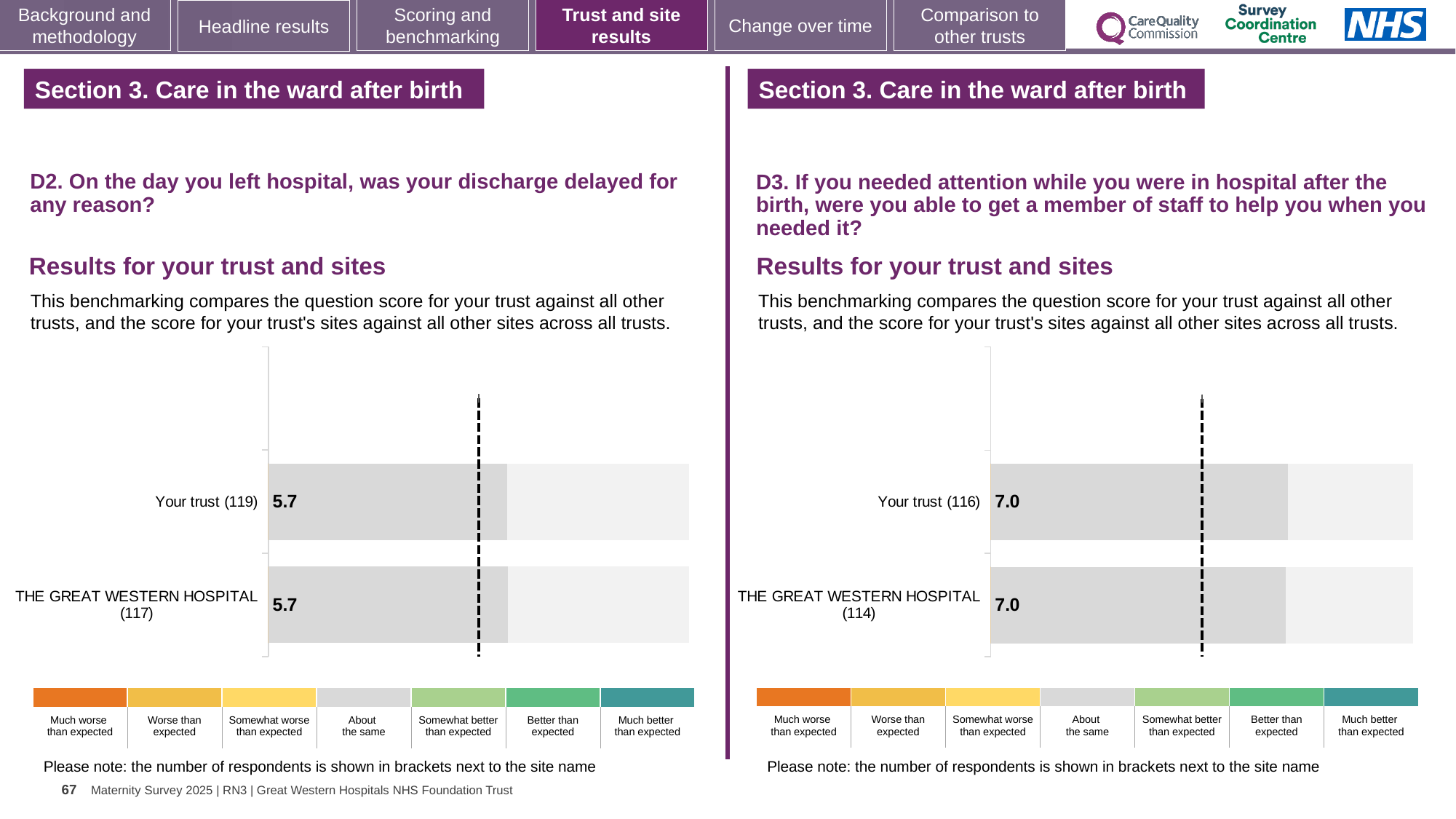
In the D2 chart on the left, what is the difference between the score for Your trust and the score for THE GREAT WESTERN HOSPITAL? 0.0 What kind of chart is the D2 chart on the left? Bar chart In the D2 chart on the left, what is the score for THE GREAT WESTERN HOSPITAL? 5.7 In the D3 chart on the right, what is the score for Your trust? 7.0 In the D2 chart on the left, how many respondents are shown in brackets for Your trust? 119 In the D3 chart on the right, what is the score for THE GREAT WESTERN HOSPITAL? 7.0 In the D3 chart on the right, how many respondents are shown in brackets for Your trust? 116 In the D2 chart on the left, how many bars are plotted? 2 In the D3 chart on the right, how many bars are plotted? 2 In the D2 chart on the left, how many respondents are shown in brackets for THE GREAT WESTERN HOSPITAL? 117 In the D3 chart on the right, how many respondents are shown in brackets for THE GREAT WESTERN HOSPITAL? 114 In the D2 chart on the left, what is the score for Your trust? 5.7